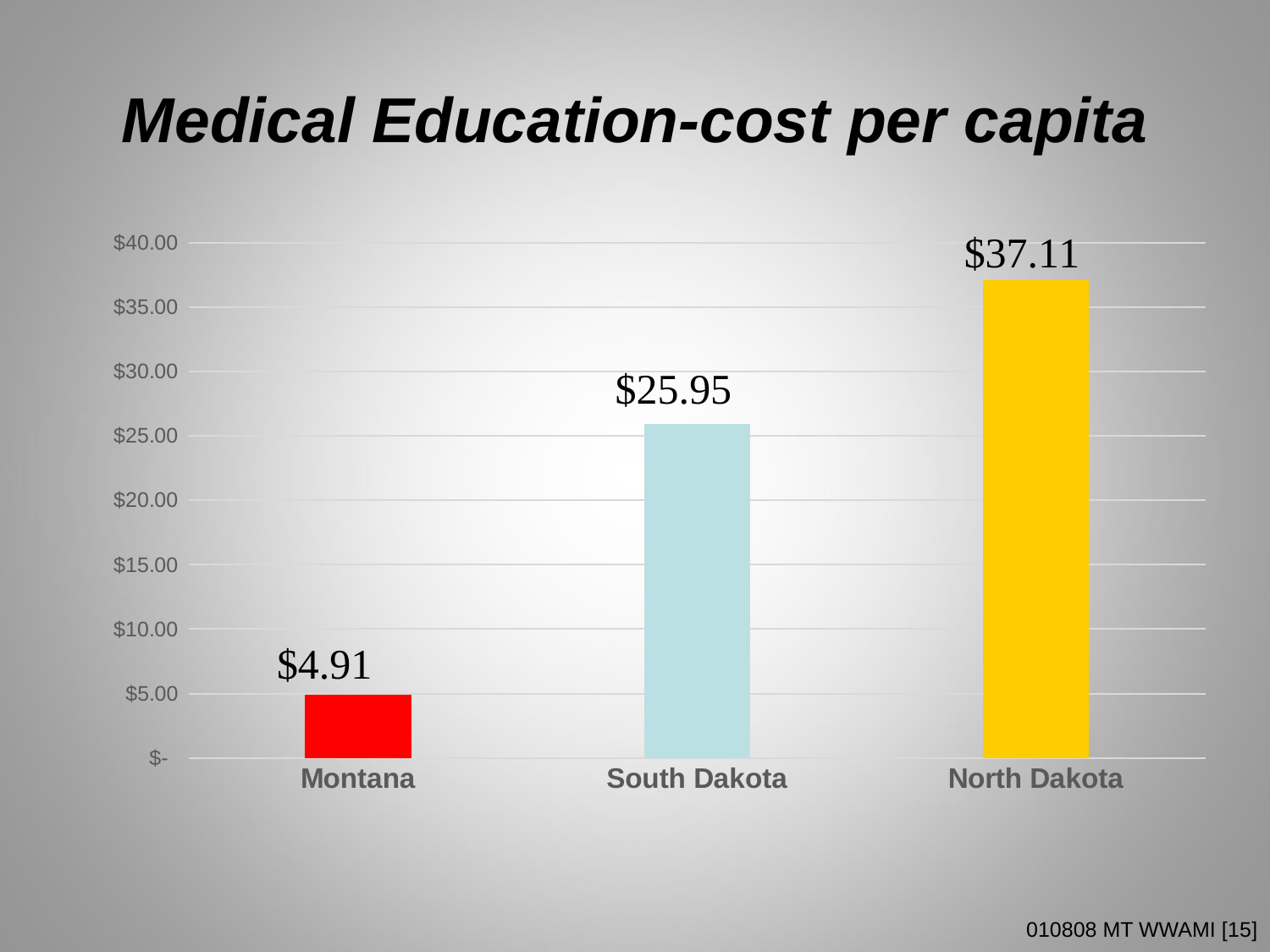
Which state has the lowest medical education cost per capita? Montana What is the title of the chart? Medical Education-cost per capita Which state has the highest medical education cost per capita? North Dakota What is the medical education cost per capita for South Dakota? $25.95 What is the difference between North Dakota's and Montana's medical education cost per capita? $32.20 Is the value for South Dakota greater or less than $30.00? less Which has a higher medical education cost per capita, South Dakota or Montana? South Dakota How many states are shown in the chart? 3 What is the medical education cost per capita for Montana? $4.91 What kind of chart is shown on the slide? Bar chart What is the difference between North Dakota's and South Dakota's medical education cost per capita? $11.16 What is the medical education cost per capita for North Dakota? $37.11